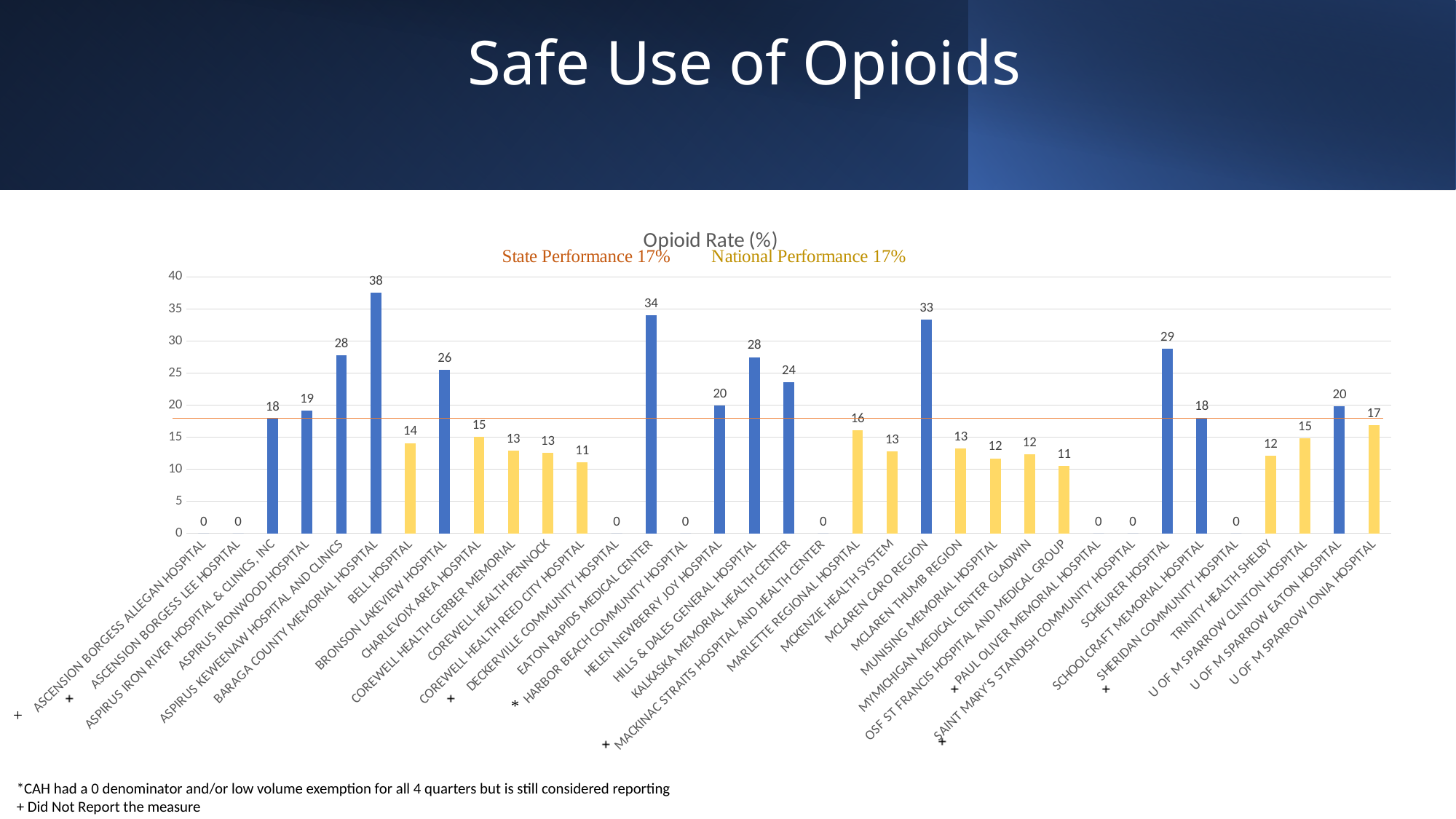
Which has a higher opioid rate, McLaren Caro Region or Scheurer Hospital? McLaren Caro Region Is the opioid rate for Hills & Dales General Hospital greater or less than 25? greater What is the difference between the opioid rates of Baraga County Memorial Hospital and Eaton Rapids Medical Center? 4 What is the opioid rate for Eaton Rapids Medical Center? 34 What is the opioid rate for Bell Hospital? 14 Which hospital has the highest opioid rate? Baraga County Memorial Hospital What is the difference between the opioid rates of Bronson Lakeview Hospital and Bell Hospital? 12 What is the opioid rate for Kalkaska Memorial Health Center? 24 What is the opioid rate for U of M Sparrow Ionia Hospital? 17 What is the State Performance value shown above the chart? 17% What kind of chart is shown on the slide? bar chart What is the opioid rate for Baraga County Memorial Hospital? 38